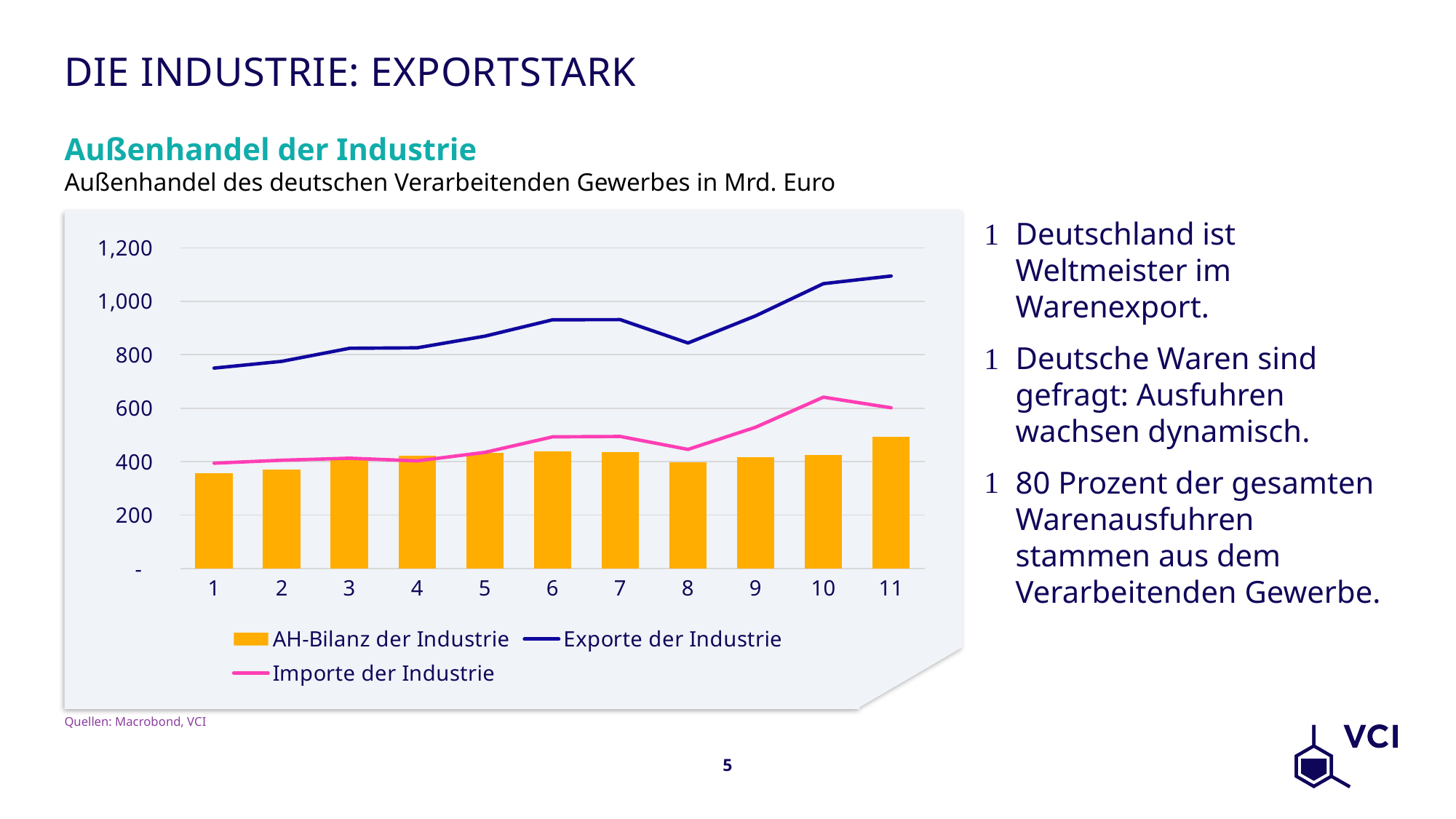
Is the value of Importe der Industrie at category 10 greater or less than 600? greater What kind of chart is shown on the slide? A combined bar and line chart Is the value of Exporte der Industrie at category 11 greater or less than 1,000? greater Is the value of Exporte der Industrie at category 1 greater or less than 800? less At which category does the Importe der Industrie line reach its highest value? 10 At which category does the Exporte der Industrie line reach its highest value? 11 How many categories are shown on the x axis? 11 Does the Exporte der Industrie line generally rise or fall from category 1 to category 11? Rise Which category has the highest bar for AH-Bilanz der Industrie? 11 Which category has the lowest bar for AH-Bilanz der Industrie? 1 Which is larger for Exporte der Industrie: the value at category 10 or at category 8? Category 10 How many series does the legend list? 3